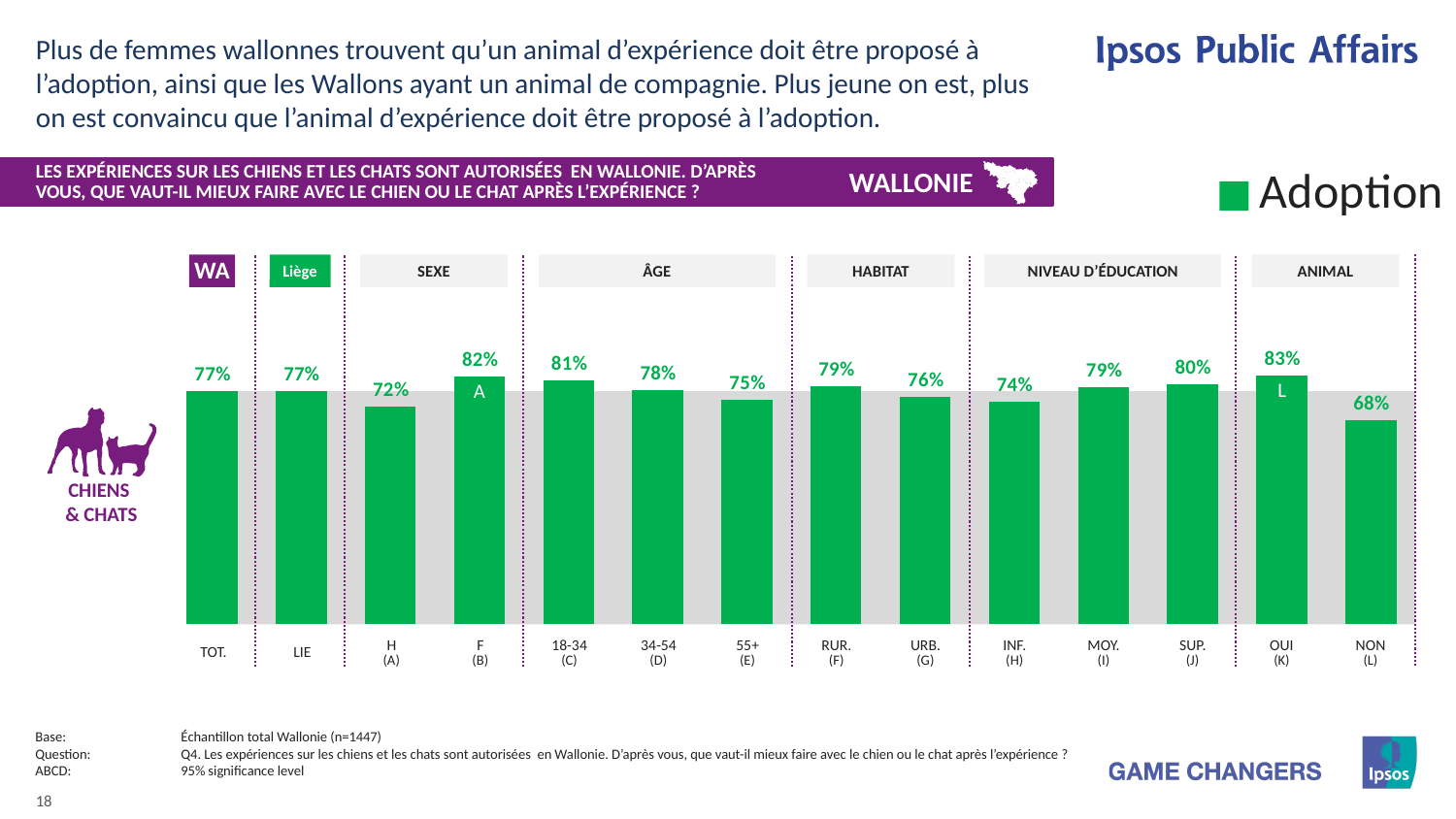
What kind of chart is shown? Bar chart What is the difference between the values for F (B) and H (A)? 10% What is the value for TOT. (WA)? 77% What is the value for the 18-34 (C) age group? 81% What is the value for F (B) under SEXE? 82% Which category has the highest value? OUI (K) How many bars are plotted in the chart? 14 Which category has the lowest value? NON (L) How many series does the legend list? 1 What is the value for NON (L) under ANIMAL? 68% What is the difference between the values for OUI (K) and NON (L)? 15% Which is larger, the value for RUR. (F) or URB. (G)? RUR. (F)